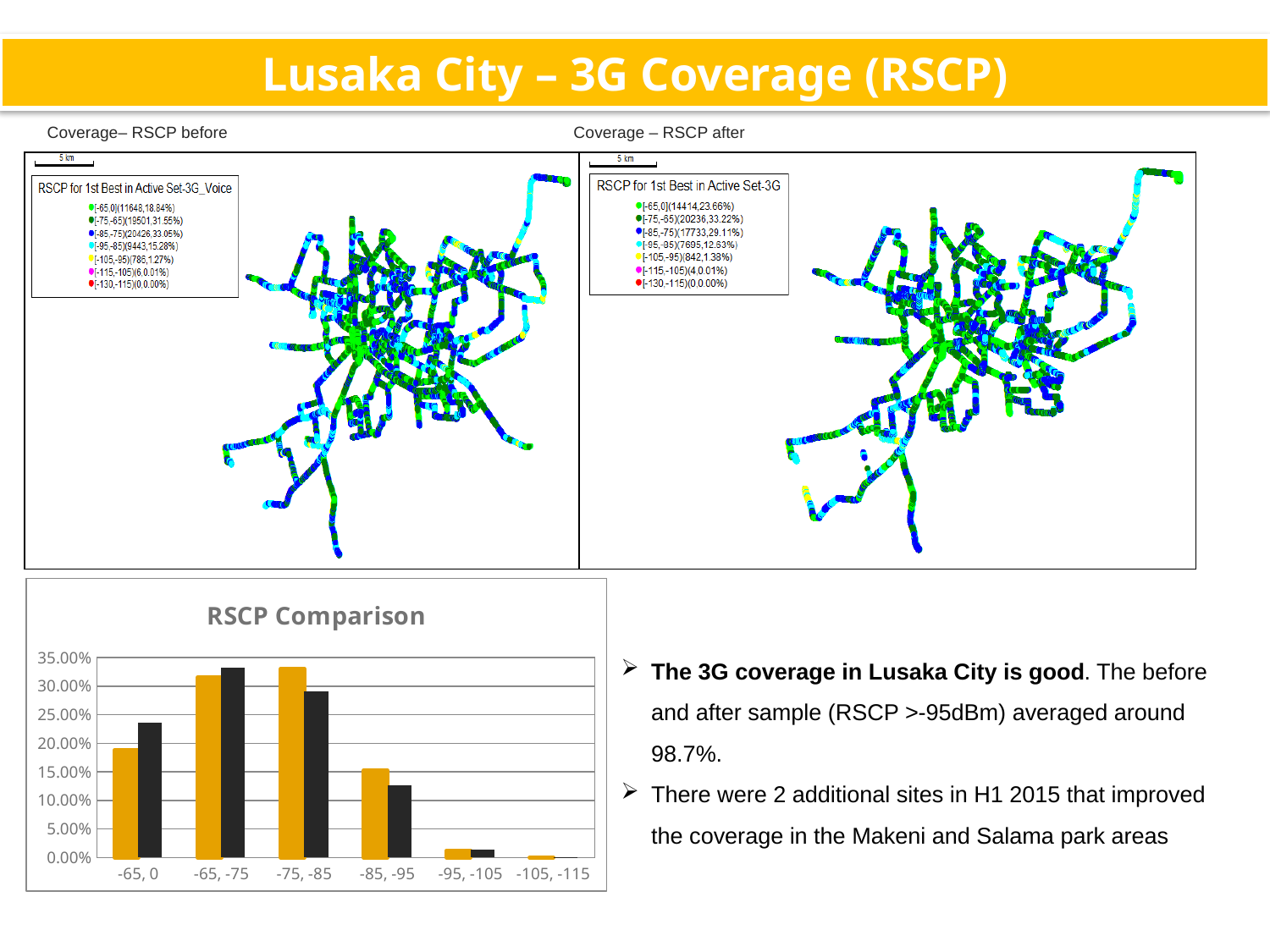
In the RSCP Comparison chart, do the dark bars rise or fall from -65, -75 to -105, -115? fall In the RSCP Comparison chart, which category has the shortest orange bar? -105, -115 What kind of chart is the RSCP Comparison chart? bar chart In the RSCP Comparison chart, is the dark bar for -85, -95 greater or less than 15.00%? less How many categories are shown on the x axis of the RSCP Comparison chart? 6 In the RSCP Comparison chart, is the dark bar for -65, 0 greater or less than 20.00%? greater In the RSCP Comparison chart, for the -75, -85 category, is the orange bar or the dark bar taller? orange bar What is the title of the bar chart at the bottom left of the slide? RSCP Comparison In the RSCP Comparison chart, is the orange bar for -65, 0 greater or less than 20.00%? less In the RSCP Comparison chart, which category has the tallest dark bar? -65, -75 In the RSCP Comparison chart, for the -65, 0 category, is the orange bar or the dark bar taller? dark bar What two colours are used for the bars in the RSCP Comparison chart? orange and dark gray